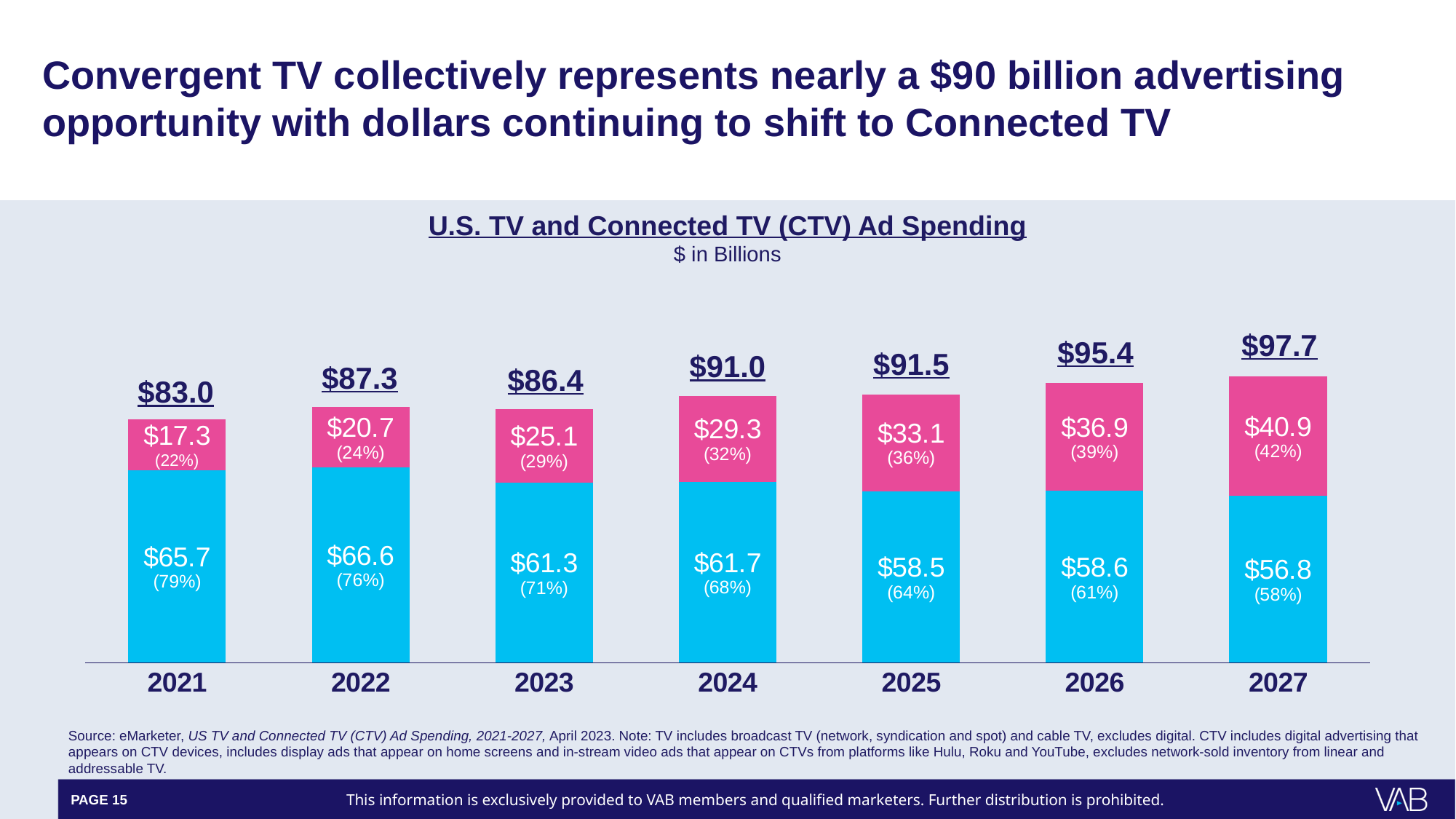
What is the title of the chart? U.S. TV and Connected TV (CTV) Ad Spending Which year has the lowest total value? 2021 What is the value of the top (pink) segment of the 2027 bar? $40.9 Which year has the highest total value? 2027 What is the difference between the total for 2027 and the total for 2021? $14.7 Which is larger, the total for 2022 or the total for 2023? 2022 Does the value of the top (pink) segment rise or fall from 2021 to 2027? Rise What percentage share is printed for the top (pink) segment in 2025? 36% What is the total value shown above the 2024 bar? $91.0 What is the value of the bottom (blue) segment of the 2021 bar? $65.7 What kind of chart is shown on the slide? Stacked bar chart How many years are shown on the x axis? 7